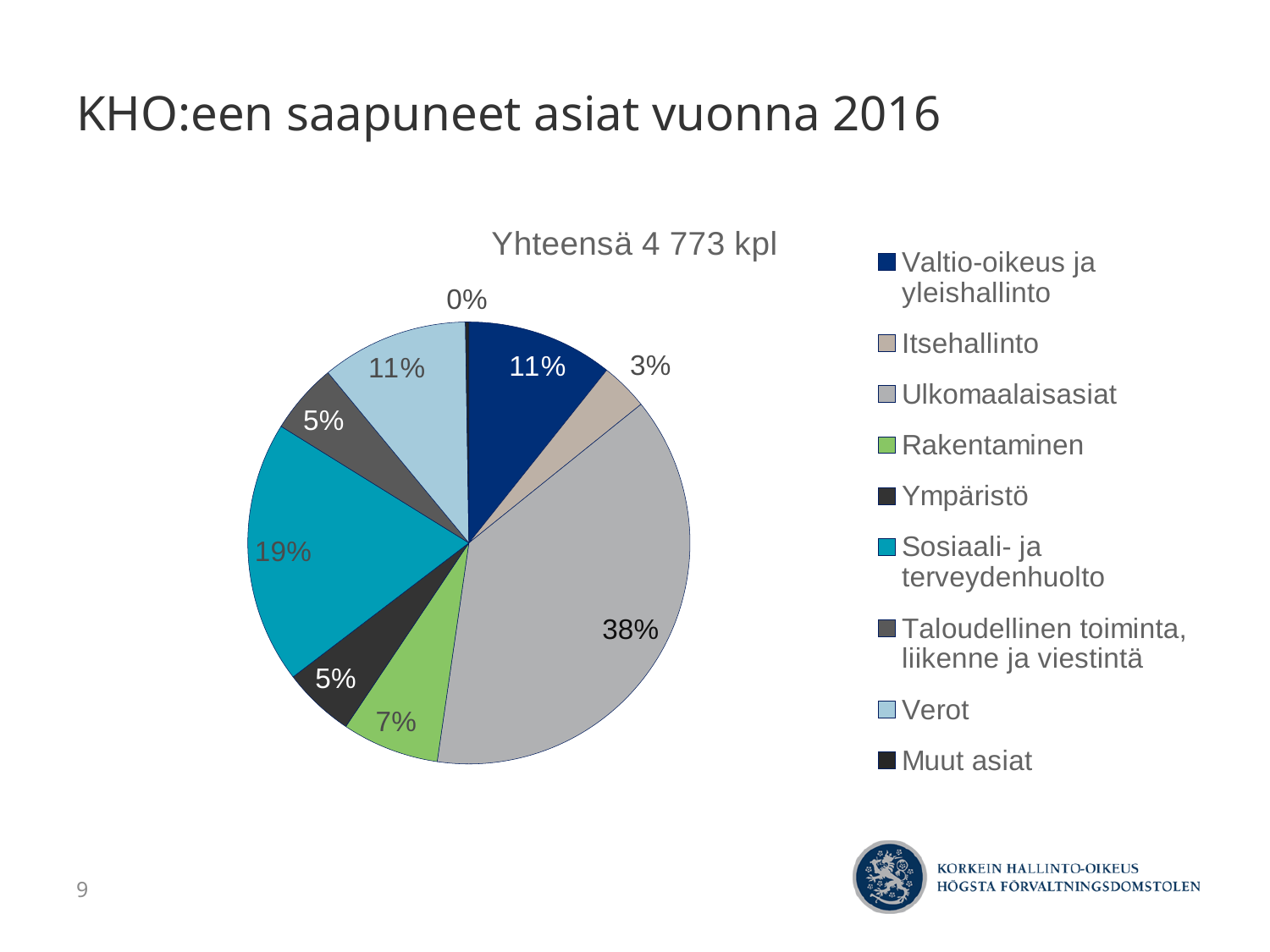
What is the value shown for Itsehallinto? 3% Which category has the largest slice of the pie? Ulkomaalaisasiat What is the value shown for Rakentaminen? 7% What total number of cases is stated in the chart title? 4 773 kpl How many categories does the legend list? 9 What is the difference between the shares of Ulkomaalaisasiat and Sosiaali- ja terveydenhuolto? 19% Which category has the smallest slice of the pie? Muut asiat What share of the pie does Sosiaali- ja terveydenhuolto have? 19% What is the value shown for Verot? 11% What share of the pie does Ulkomaalaisasiat have? 38% Which is larger, the share for Rakentaminen or the share for Itsehallinto? Rakentaminen What kind of chart is shown on the slide? pie chart